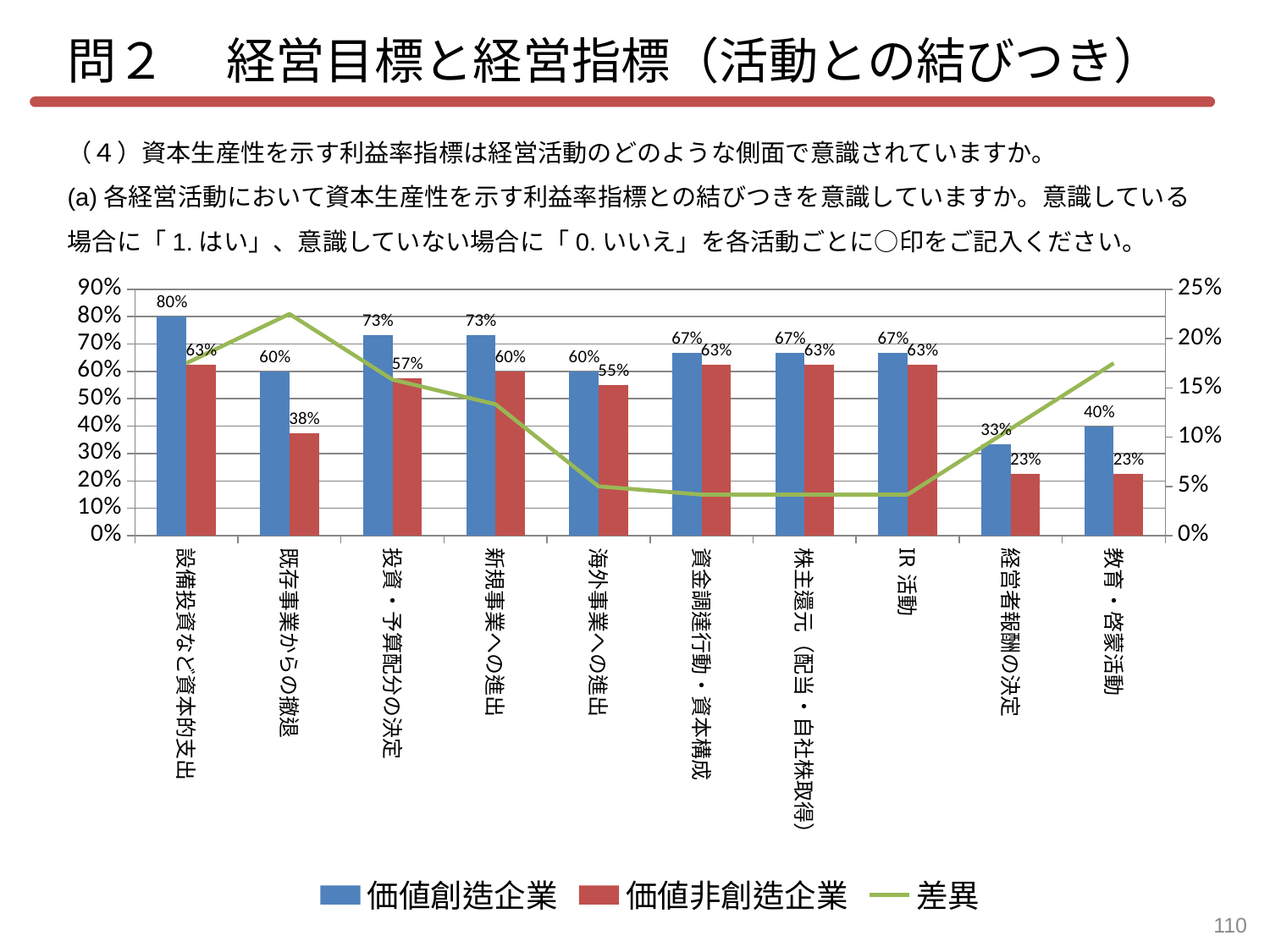
What is the value for 価値非創造企業 in the 既存事業からの撤退 category? 38% How many series does the legend list? 3 Which category has the lowest value for 価値創造企業? 経営者報酬の決定 For 価値非創造企業, which is larger: 投資・予算配分の決定 or 新規事業への進出? 新規事業への進出 What is the difference between 価値創造企業 and 価値非創造企業 in the 既存事業からの撤退 category? 22 percentage points What is the value for 価値非創造企業 in the 教育・啓蒙活動 category? 23% Is the 差異 line value for 既存事業からの撤退 greater or less than 20% on the right axis? greater Is the 差異 line value for IR活動 greater or less than 5% on the right axis? less What is the value for 価値創造企業 in the 設備投資など資本的支出 category? 80% How many categories are shown on the x axis of the chart? 10 What kind of chart is shown on the slide? Bar chart with a line series Which category has the highest value for 価値創造企業? 設備投資など資本的支出